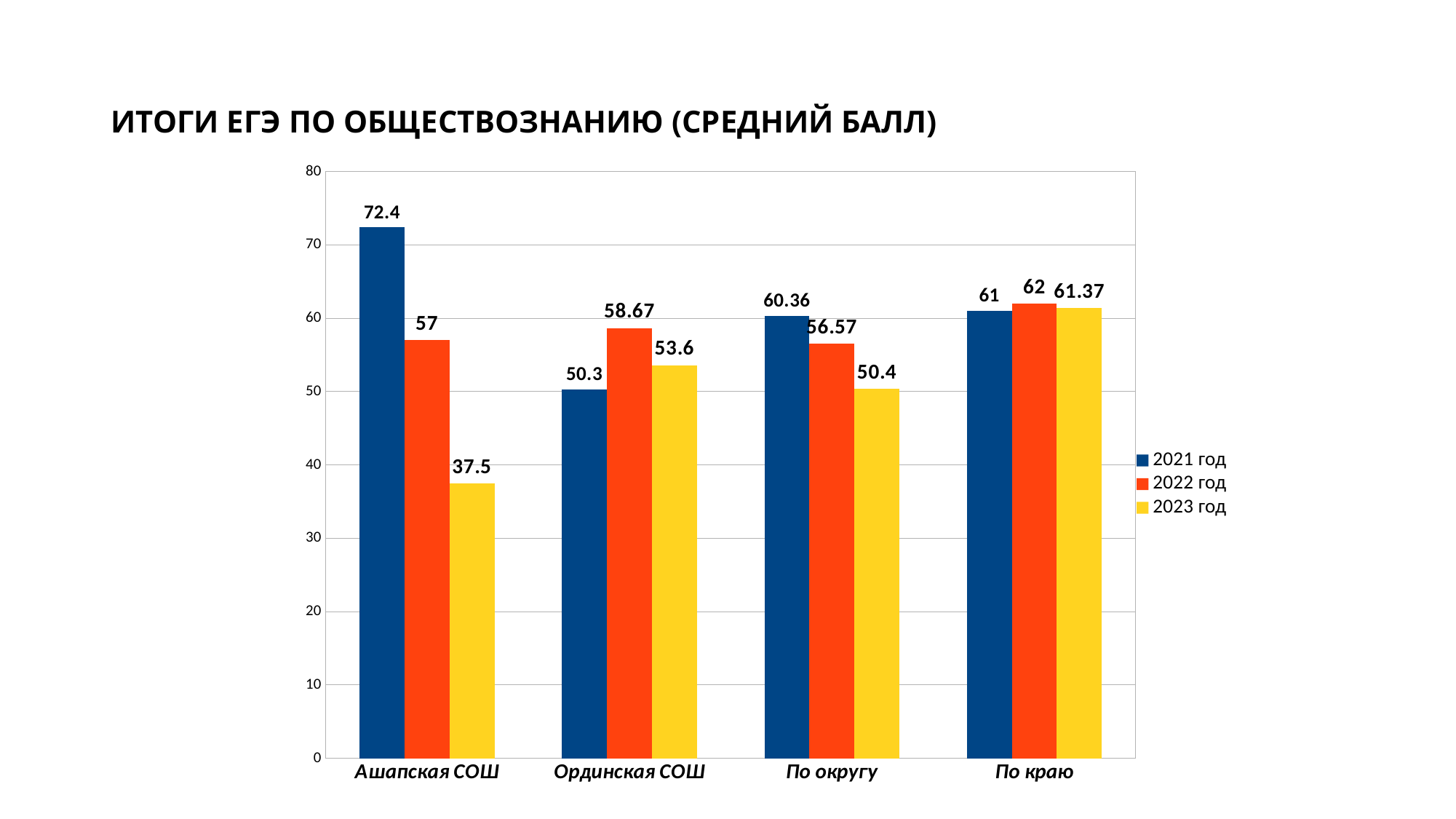
What is the value for По округу in the 2023 год series? 50.4 What is the title of the chart? ИТОГИ ЕГЭ ПО ОБЩЕСТВОЗНАНИЮ (СРЕДНИЙ БАЛЛ) What is the value for Ашапская СОШ in the 2021 год series? 72.4 How many series does the legend list? 3 What kind of chart is shown on the slide? bar chart What is the difference between the 2021 год and 2023 год values for Ашапская СОШ? 34.9 What is the value for По краю in the 2022 год series? 62 Which category has the highest value in the 2021 год series? Ашапская СОШ How many categories are shown on the x axis? 4 Which category has the lowest value in the 2023 год series? Ашапская СОШ What is the value for Ординская СОШ in the 2022 год series? 58.67 Which is larger for Ординская СОШ: the 2021 год value or the 2022 год value? 2022 год